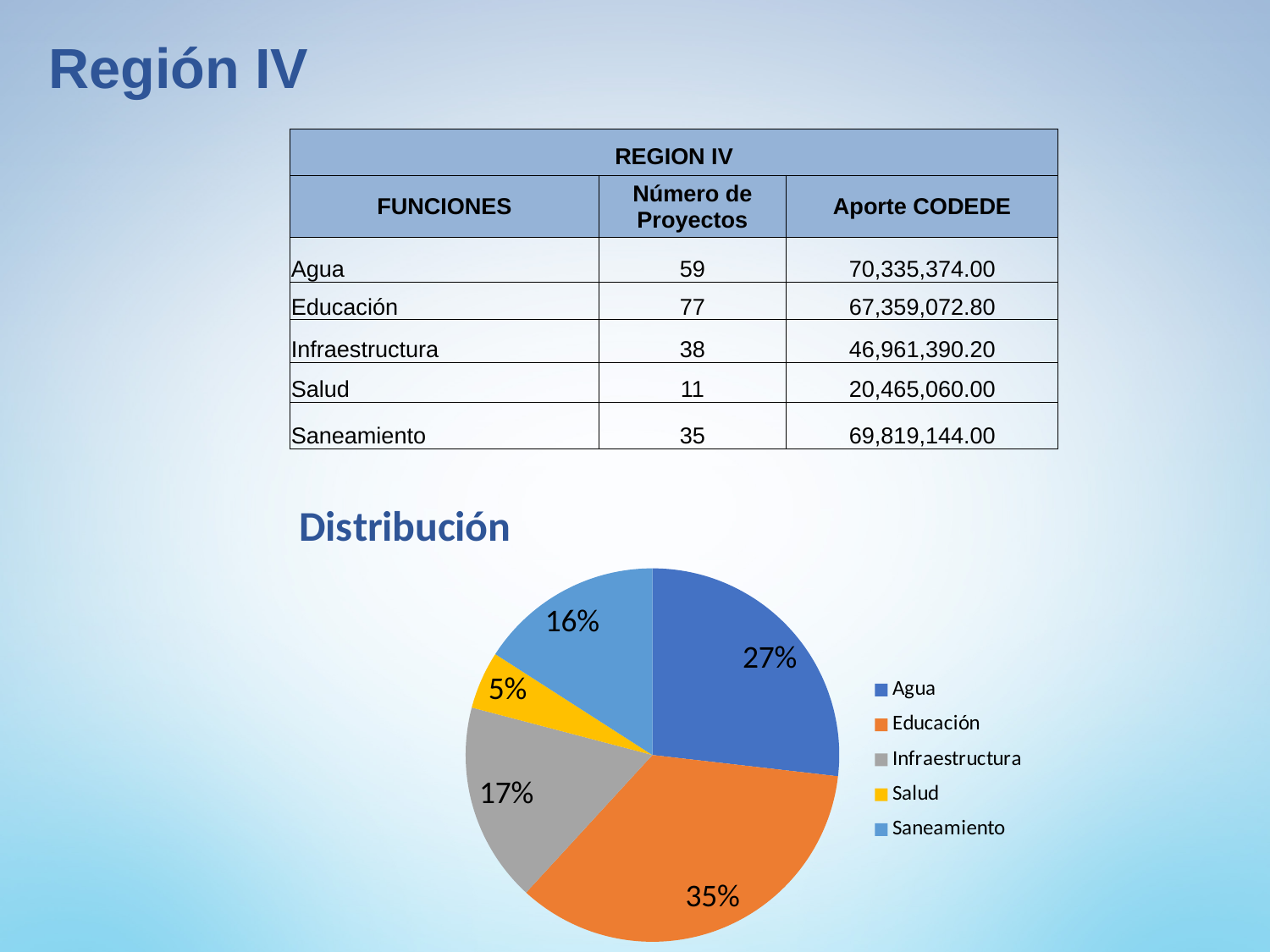
Which category has the largest slice in the pie chart? Educación What share of the pie chart does Infraestructura represent? 17% What is the difference in percentage points between the Educación and Agua slices? 8% How many categories does the pie chart show? 5 What is the title of the pie chart? Distribución What share of the pie chart does Saneamiento represent? 16% What kind of chart is shown under the heading "Distribución"? Pie chart Which category has the smallest slice in the pie chart? Salud Which slice is larger in the pie chart, Infraestructura or Saneamiento? Infraestructura What share of the pie chart does Educación represent? 35%